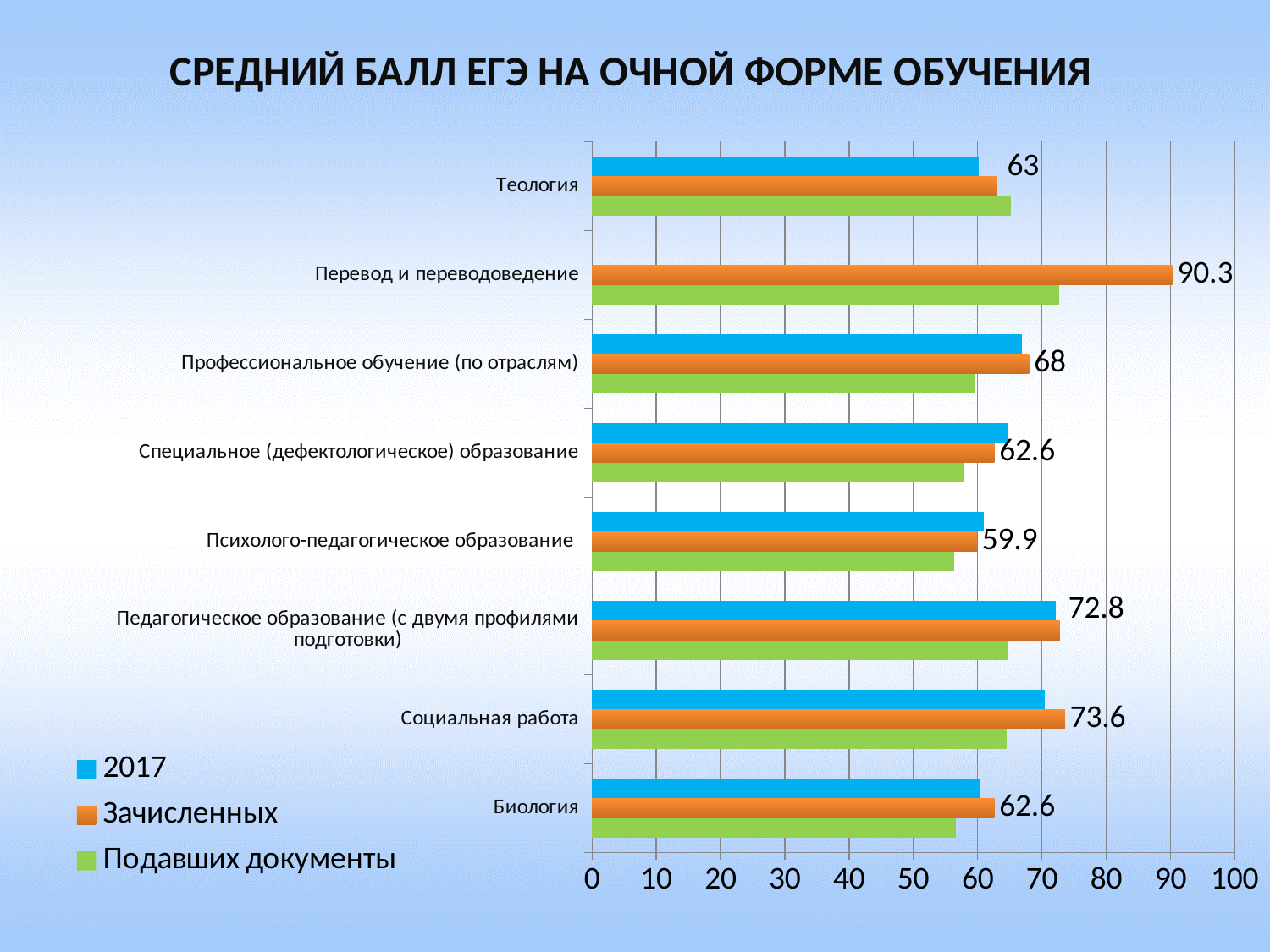
What is the value for Зачисленных for Перевод и переводоведение? 90.3 What is the value for Зачисленных for Социальная работа? 73.6 What is the value for Зачисленных for Теология? 63 Which category has the highest value for Зачисленных? Перевод и переводоведение Which category has the lowest value for Зачисленных? Психолого-педагогическое образование How many series does the legend list? 3 What is the value for Зачисленных for Психолого-педагогическое образование? 59.9 What is the difference between the Зачисленных values for Перевод и переводоведение and Социальная работа? 16.7 How many categories (programmes) are shown on the chart? 8 What type of chart is shown on the slide? bar chart Is the Подавших документы value for Психолого-педагогическое образование greater or less than 60? less Which series is shown in orange in the legend? Зачисленных